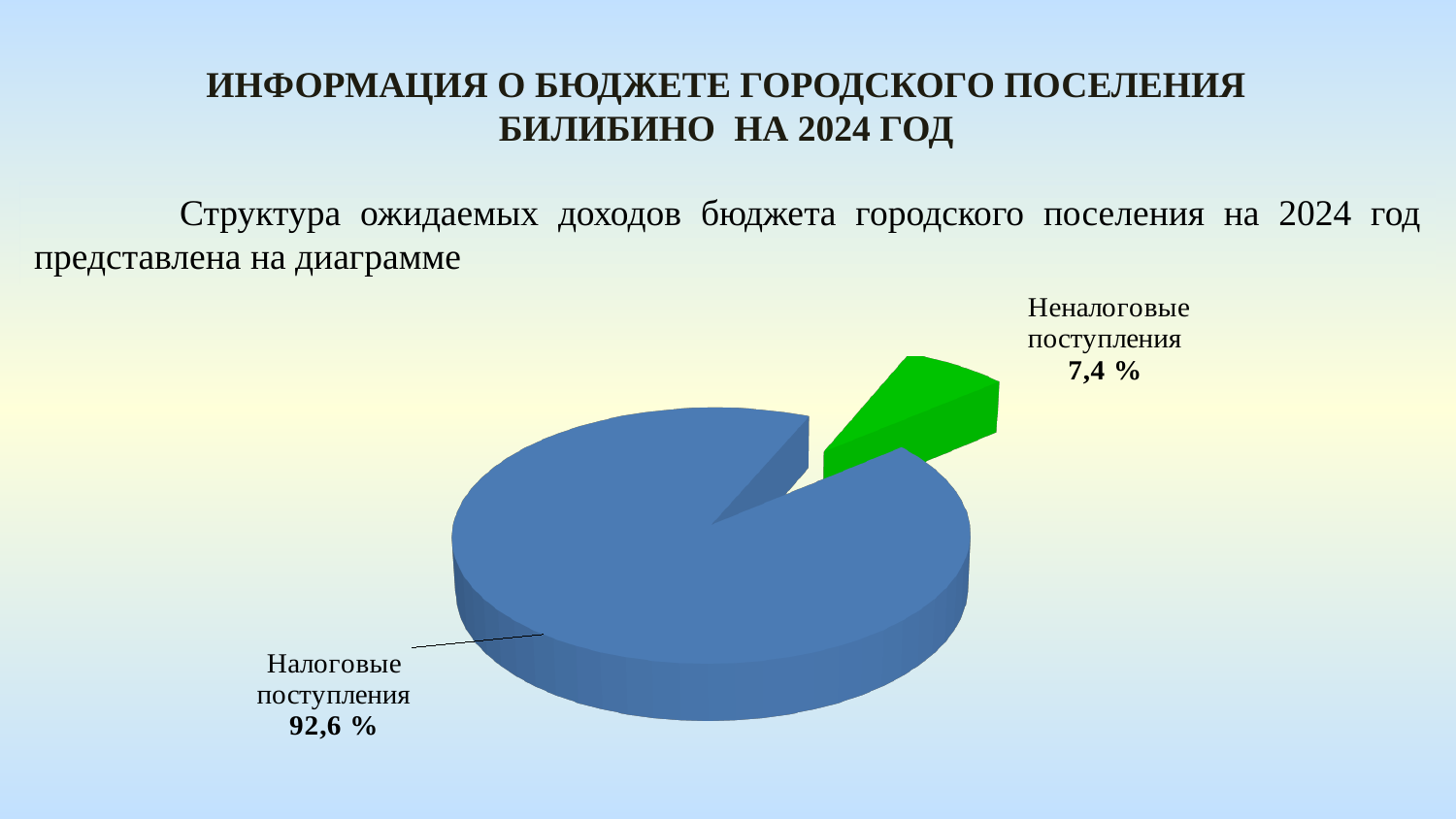
Which is larger, Налоговые поступления or Неналоговые поступления? Налоговые поступления What share of the pie is labelled Неналоговые поступления? 7,4 % What is the difference in percentage points between Налоговые поступления and Неналоговые поступления? 85,2 What share of the pie is labelled Налоговые поступления? 92,6 % What colour is the slice for Налоговые поступления? blue Is the share for Неналоговые поступления greater or less than 10%? less What colour is the slice for Неналоговые поступления? green Which slice of the pie is the largest? Налоговые поступления Which slice of the pie is the smallest? Неналоговые поступления What kind of chart is shown on the slide? pie chart How many slices does the pie chart have? 2 Is the share for Налоговые поступления greater or less than 90%? greater